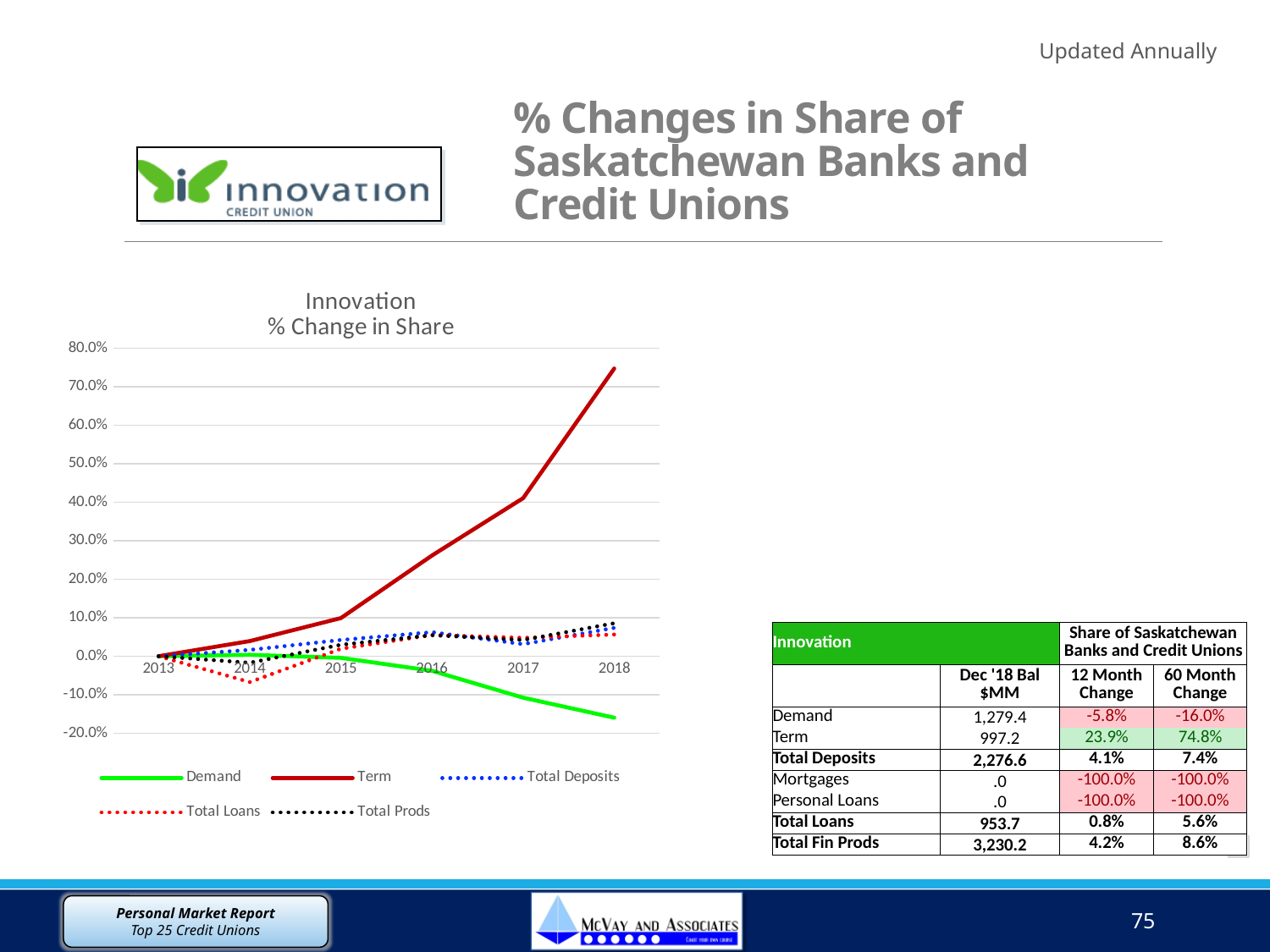
Which series has the highest value in 2018? Term Does the Demand series rise or fall from 2015 to 2018? fall How many series does the chart legend list? 5 Is the value for Term in 2018 greater or less than 70.0%? greater How many years are plotted along the x axis of the chart? 6 Which series has the lowest value in 2018? Demand What is the title of the chart? Innovation % Change in Share Which series is drawn as a solid red line in the chart? Term What kind of chart is shown on the slide? line chart Does the Term series rise or fall from 2013 to 2018? rise Is the value for Demand in 2018 greater or less than -10.0%? less In 2016, which is larger: the value for Term or the value for Demand? Term